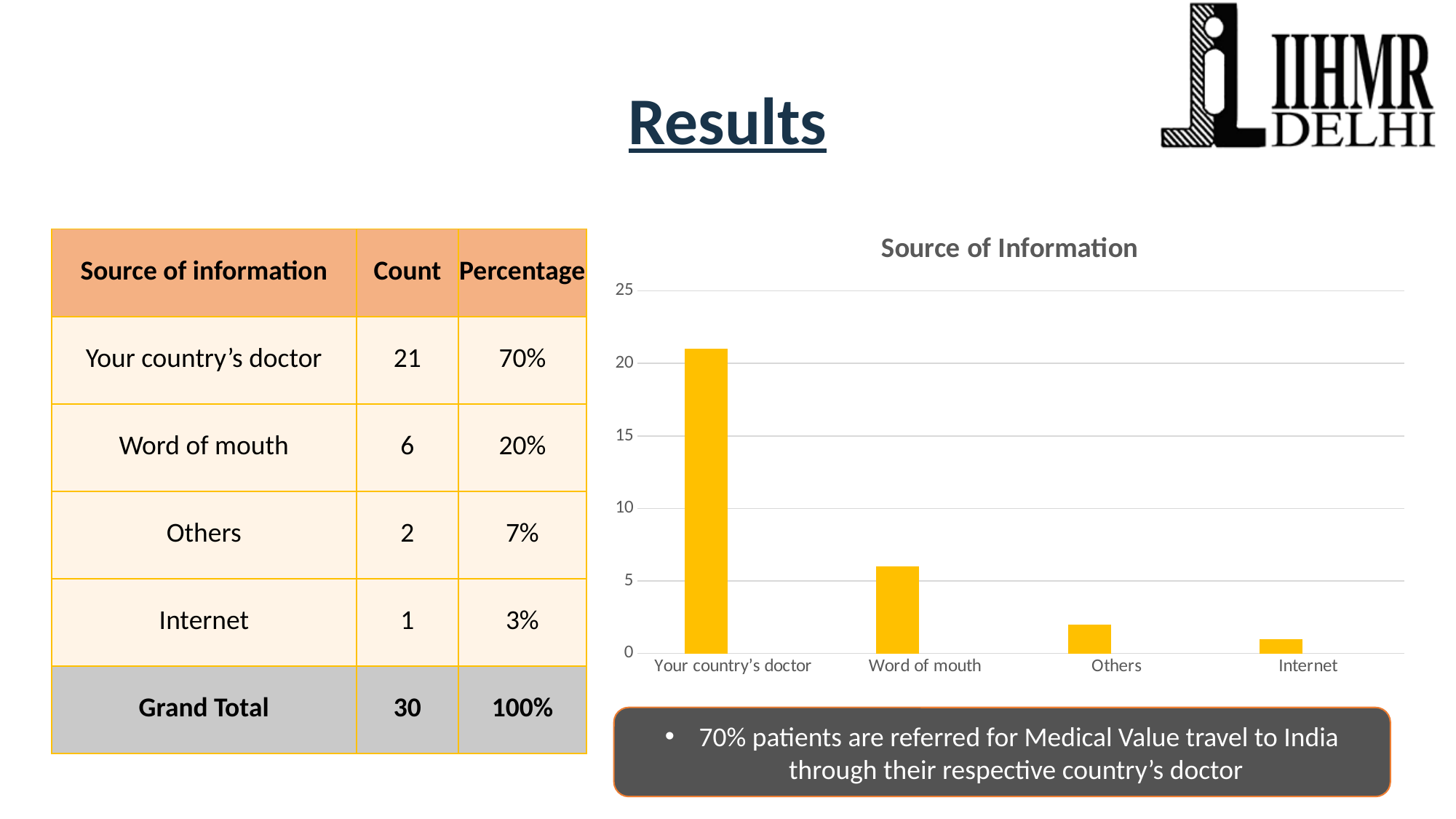
What is the difference between the values for Your country's doctor and Word of mouth? 15 How many categories are shown on the x axis of the chart? 4 What is the value for Others in the chart? 2 Which category has the lowest bar in the chart? Internet Is the value for Your country's doctor greater or less than 20? greater What is the value for Word of mouth in the chart? 6 What is the value for Your country's doctor in the chart? 21 What type of chart is shown on the slide? bar chart Which is larger, the value for Others or the value for Internet? Others What is the title of the chart? Source of Information Which category has the highest bar in the chart? Your country's doctor Is the value for Word of mouth greater or less than 10? less